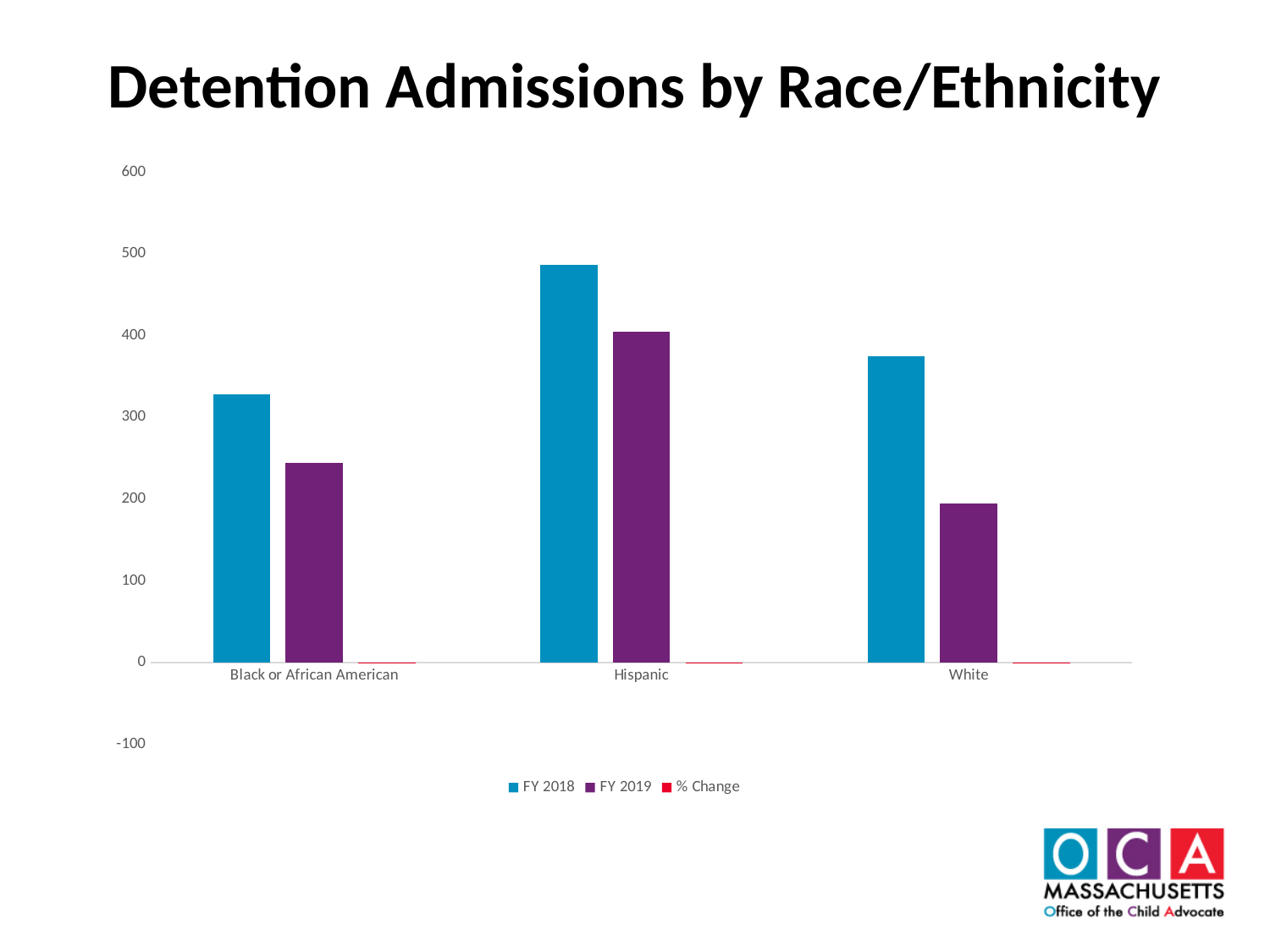
Is the FY 2018 value for Hispanic greater or less than 400? greater Which category has the lowest FY 2018 value? Black or African American Which is larger: the FY 2019 value for Hispanic or the FY 2018 value for White? FY 2019 value for Hispanic For White, which is larger: the FY 2018 value or the FY 2019 value? FY 2018 What is the title of the chart? Detention Admissions by Race/Ethnicity Is the FY 2018 value for Black or African American greater or less than 300? greater What kind of chart is shown on the slide? bar chart Which category has the lowest FY 2019 value? White How many series does the legend list? 3 How many race/ethnicity categories are shown on the x axis? 3 Which category has the highest FY 2018 value? Hispanic